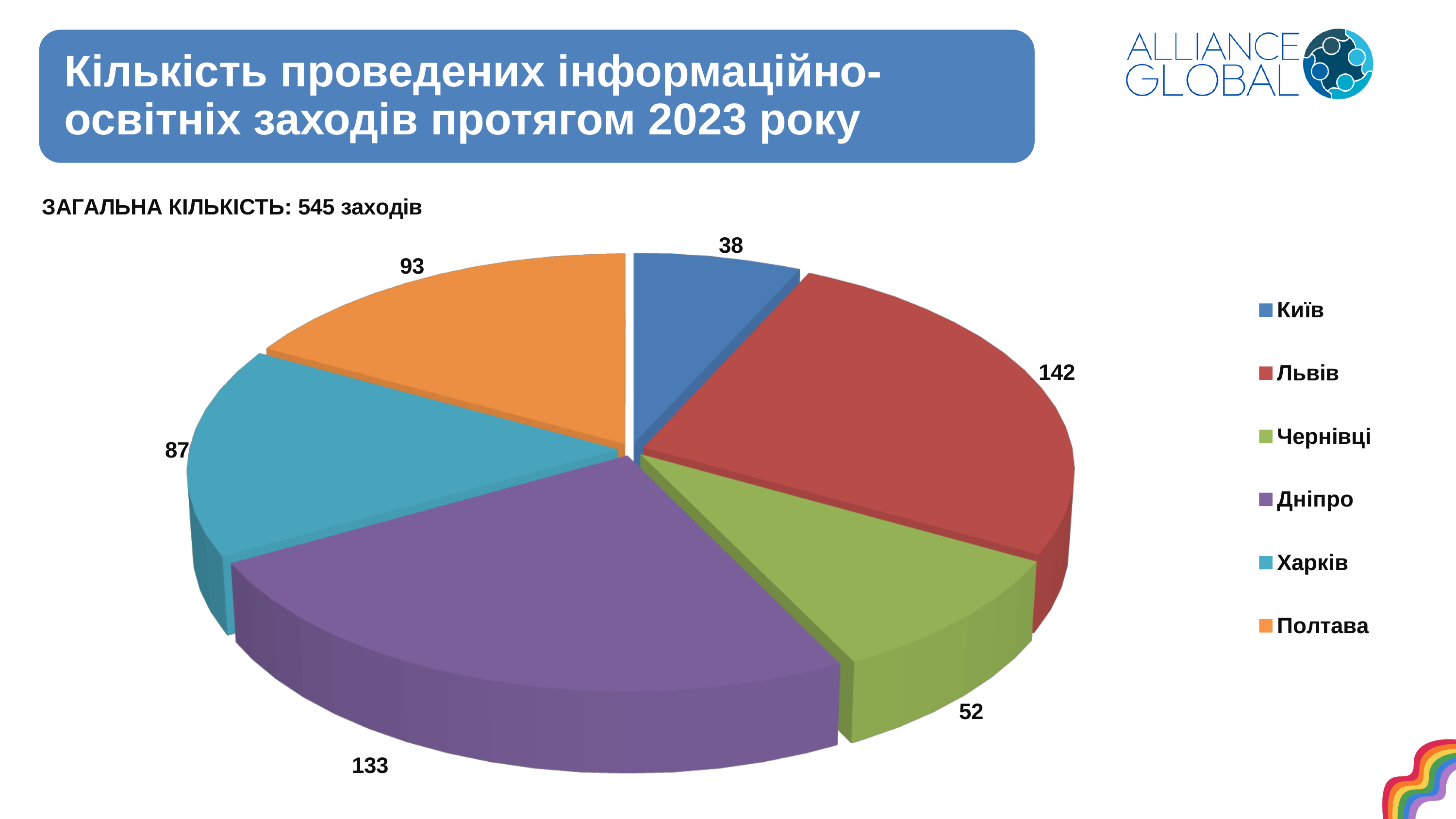
What is the difference between the values for Львів and Дніпро? 9 Which city has the largest slice of the pie? Львів Which is larger, the value for Чернівці or the value for Харків? Харків What is the difference between the values for Полтава and Харків? 6 What colour is the slice for Дніпро? Purple What is the value shown for Харків? 87 What is the value shown for Дніпро? 133 Which city has the smallest slice of the pie? Київ How many events does the pie chart show for Львів? 142 What is the value shown for Київ? 38 What kind of chart is shown on the slide? Pie chart How many cities are shown in the pie chart? 6